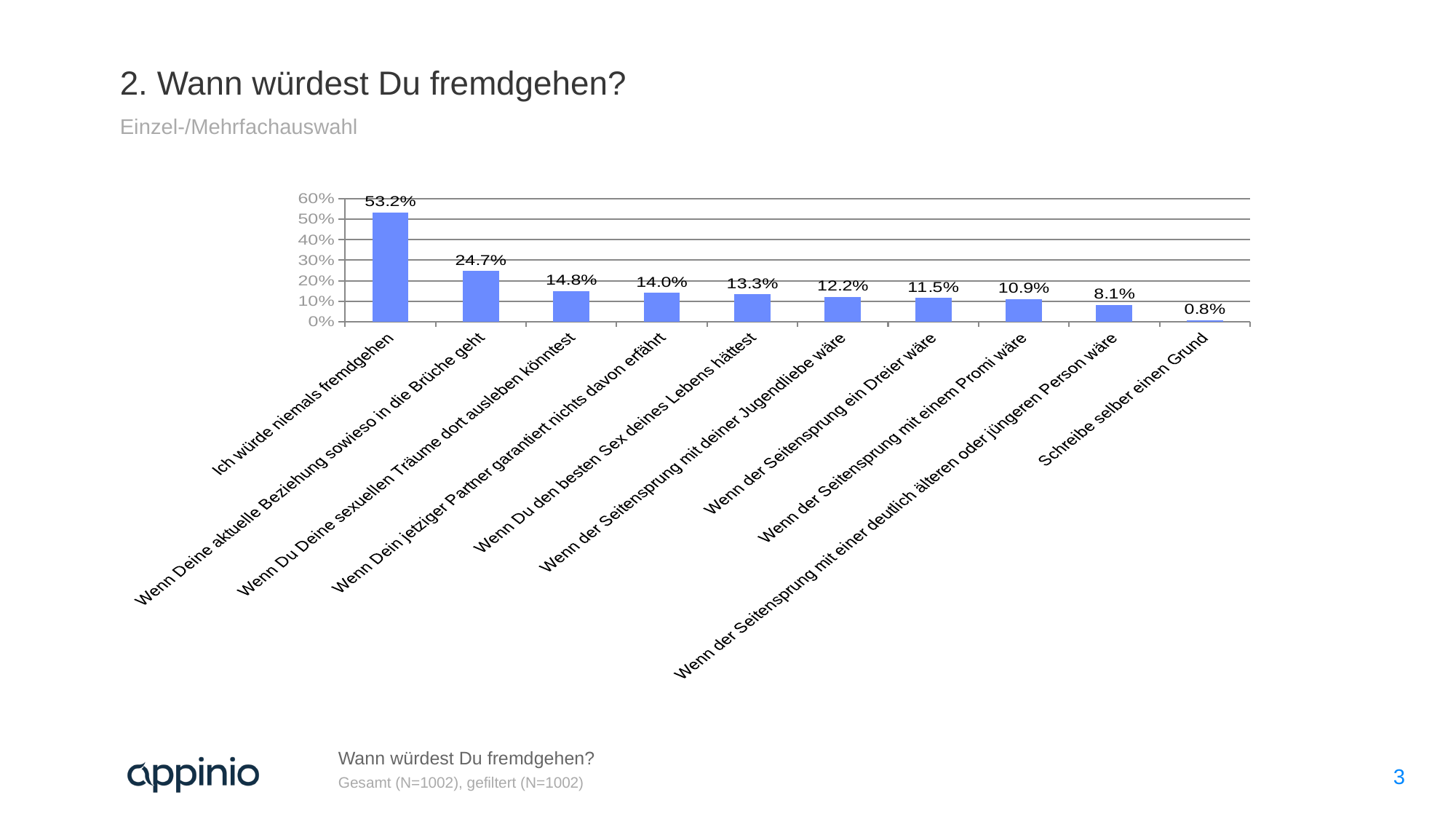
How many categories are shown in the chart? 10 What is the value for "Wenn der Seitensprung ein Dreier wäre"? 11.5% What percentage of respondents chose "Ich würde niemals fremdgehen"? 53.2% What is the highest value shown on the y axis? 60% Do the values rise or fall from left to right along the x axis? fall Is the value for "Wenn Deine aktuelle Beziehung sowieso in die Brüche geht" greater or less than 20%? greater What is the value for "Schreibe selber einen Grund"? 0.8% Which category has the highest value? Ich würde niemals fremdgehen Which is larger: "Wenn der Seitensprung mit einem Promi wäre" or "Wenn der Seitensprung mit einer deutlich älteren oder jüngeren Person wäre"? Wenn der Seitensprung mit einem Promi wäre What is the difference between "Ich würde niemals fremdgehen" and "Wenn Deine aktuelle Beziehung sowieso in die Brüche geht"? 28.5% Which category has the lowest value? Schreibe selber einen Grund What kind of chart is shown on the slide? bar chart